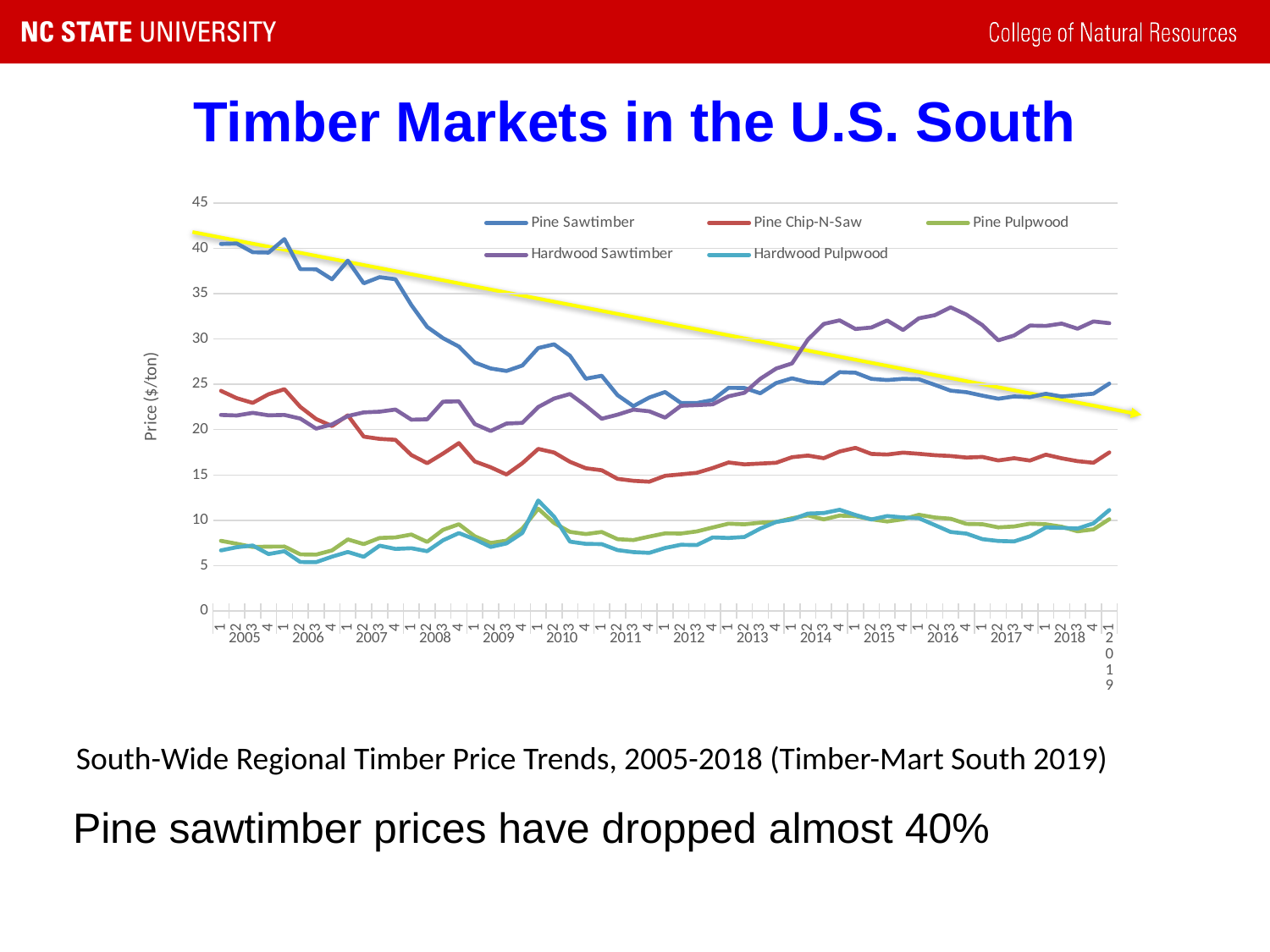
Is the Pine Chip-N-Saw value in 2011 greater or less than 20? less Is the Pine Pulpwood value in 2018 greater or less than 15? less Which series has the highest value at the end of 2018? Hardwood Sawtimber What kind of chart is shown on the slide? line chart Is the Pine Sawtimber value at the start of 2005 greater or less than 35? greater How many series does the chart's legend list? 5 What is the label on the chart's vertical axis? Price ($/ton) Does the Hardwood Sawtimber line rise or fall from 2005 to 2018? rise At the start of 2005, which is larger: Pine Sawtimber or Hardwood Sawtimber? Pine Sawtimber In 2016, which is larger: Hardwood Sawtimber or Pine Chip-N-Saw? Hardwood Sawtimber Does the Pine Sawtimber line rise or fall from 2005 to 2018? fall